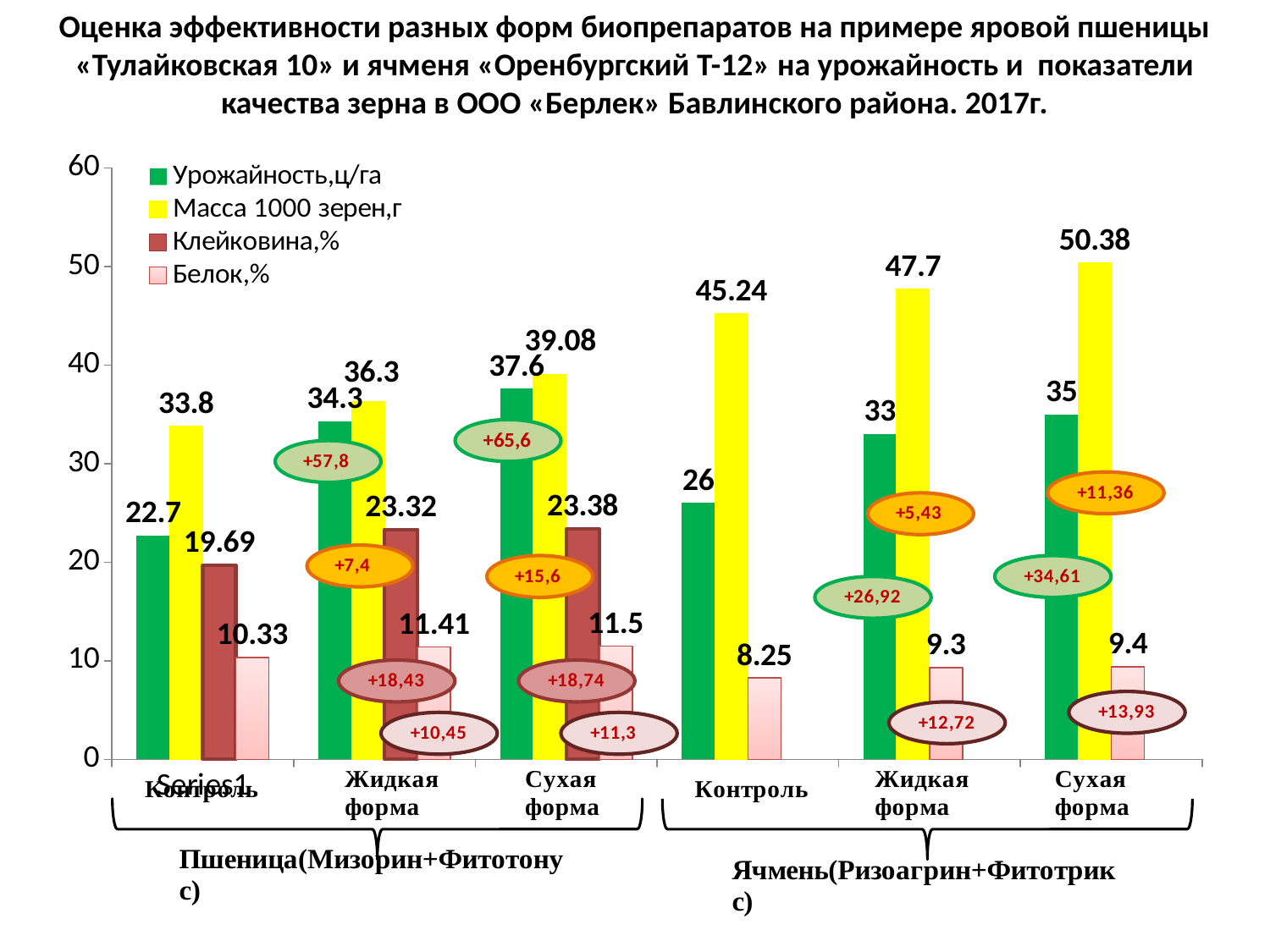
What kind of chart is shown on the slide? Bar chart Which category has the lowest Белок,% value? Контроль (Ячмень) How many series does the legend list? 4 Does the Урожайность,ц/га value rise or fall from Контроль to Сухая форма in the Ячмень group? Rise What is the difference in Масса 1000 зерен,г between Сухая форма and Жидкая форма in the Ячмень group? 2.68 Which is larger: the Масса 1000 зерен,г value for Контроль in the Пшеница group or for Контроль in the Ячмень group? Контроль in the Ячмень group What is the Урожайность,ц/га value for Сухая форма in the Пшеница group? 37.6 What is the Масса 1000 зерен,г value for Сухая форма in the Ячмень group? 50.38 What is the difference in Урожайность,ц/га between Сухая форма and Контроль in the Пшеница group? 14.9 How many categories are shown along the x axis? 6 Which category has the highest Масса 1000 зерен,г value? Сухая форма (Ячмень) What is the Белок,% value for Жидкая форма in the Пшеница group? 11.41